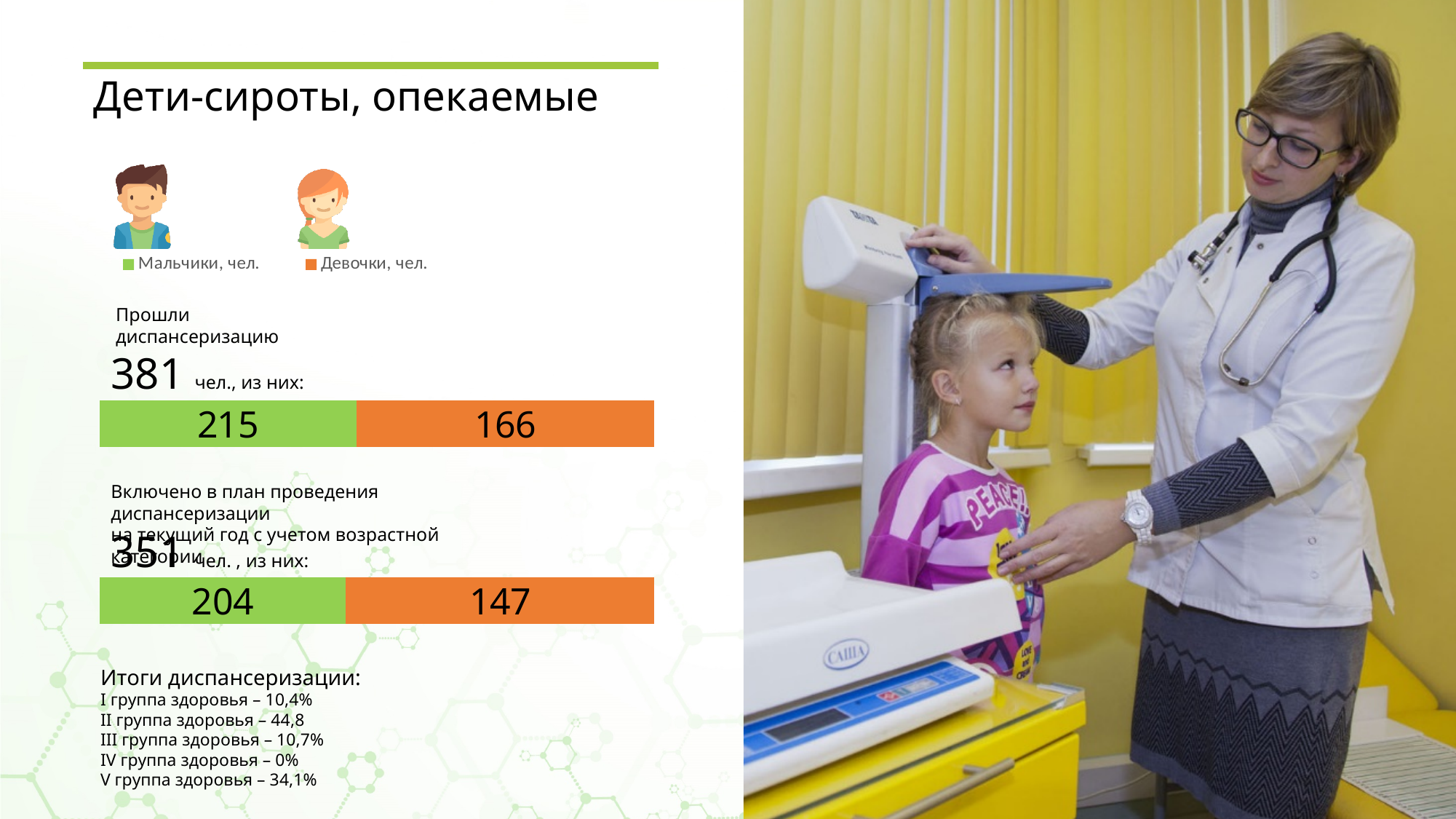
На диаграмме «Прошли диспансеризацию» кого больше — мальчиков или девочек? Мальчики Каким цветом на диаграммах обозначены девочки? Оранжевым На диаграмме «Прошли диспансеризацию» сколько девочек прошли диспансеризацию? 166 На диаграмме «Включено в план проведения диспансеризации» сколько мальчиков включено в план? 204 Каков общий итог полосы на диаграмме «Включено в план проведения диспансеризации»? 351 Каков общий итог полосы на диаграмме «Прошли диспансеризацию»? 381 На диаграмме «Прошли диспансеризацию» сколько мальчиков прошли диспансеризацию? 215 На диаграмме «Включено в план проведения диспансеризации» на сколько мальчиков больше, чем девочек? 57 На диаграмме «Прошли диспансеризацию» на сколько мальчиков больше, чем девочек? 49 Сколько рядов данных указано в легенде диаграмм на слайде? 2 На диаграмме «Включено в план проведения диспансеризации» сколько девочек включено в план? 147 На диаграмме «Включено в план проведения диспансеризации» кого меньше — мальчиков или девочек? Девочки